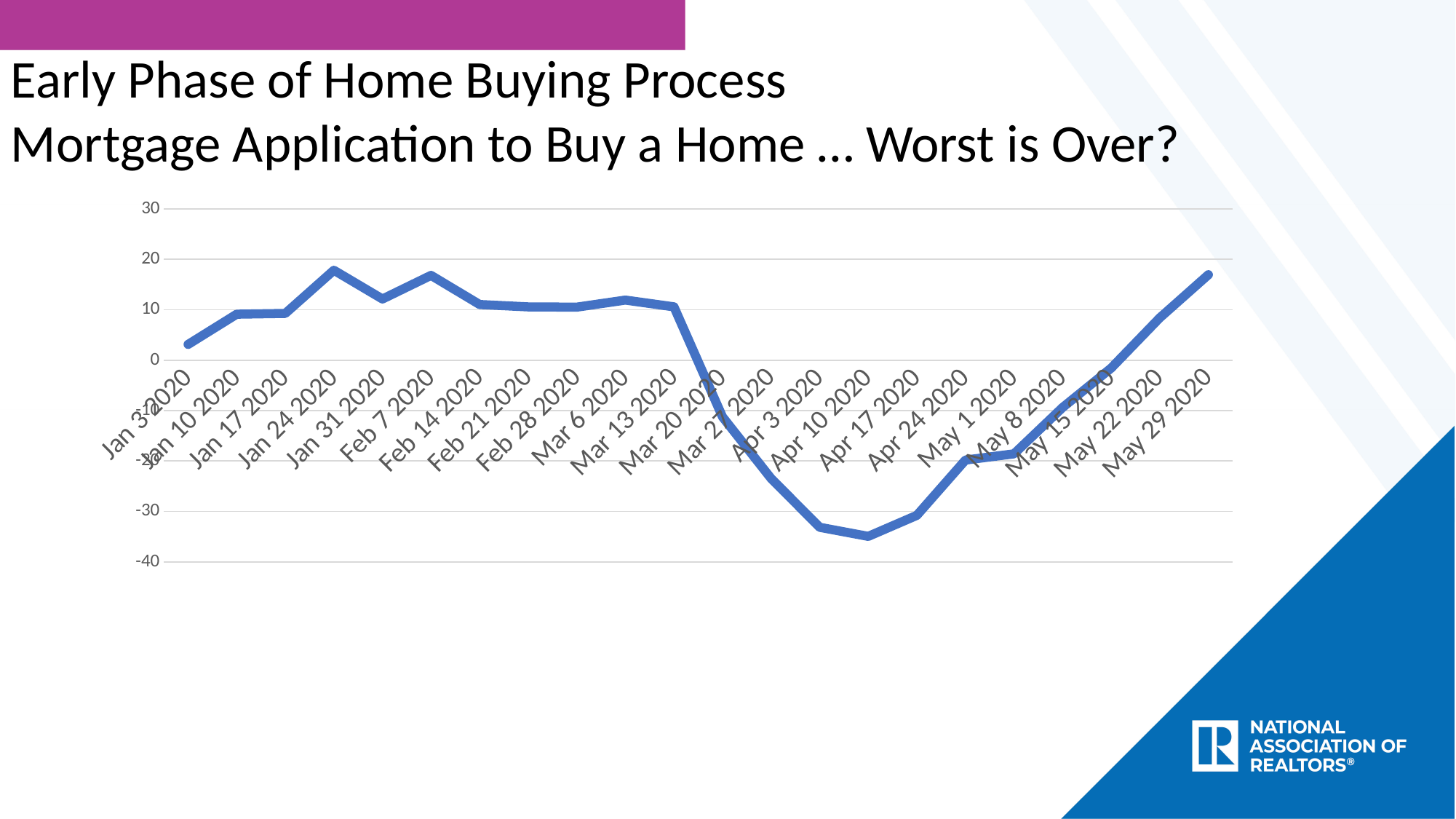
Do the values rise or fall from Apr 17 2020 to May 29 2020? rise Do the values rise or fall from Mar 13 2020 to Apr 17 2020? fall What kind of chart is shown on the slide? line chart Which is larger, the value for Jan 24 2020 or the value for Jan 31 2020? Jan 24 2020 How many weekly data points are plotted on the chart? 22 Which date has the lowest value on the chart? Apr 10 2020 Is the value for Jan 24 2020 greater or less than 10? greater Is the value for Apr 3 2020 greater or less than -20? less Is the value for May 29 2020 greater or less than 10? greater Which is larger, the value for Apr 10 2020 or the value for May 8 2020? May 8 2020